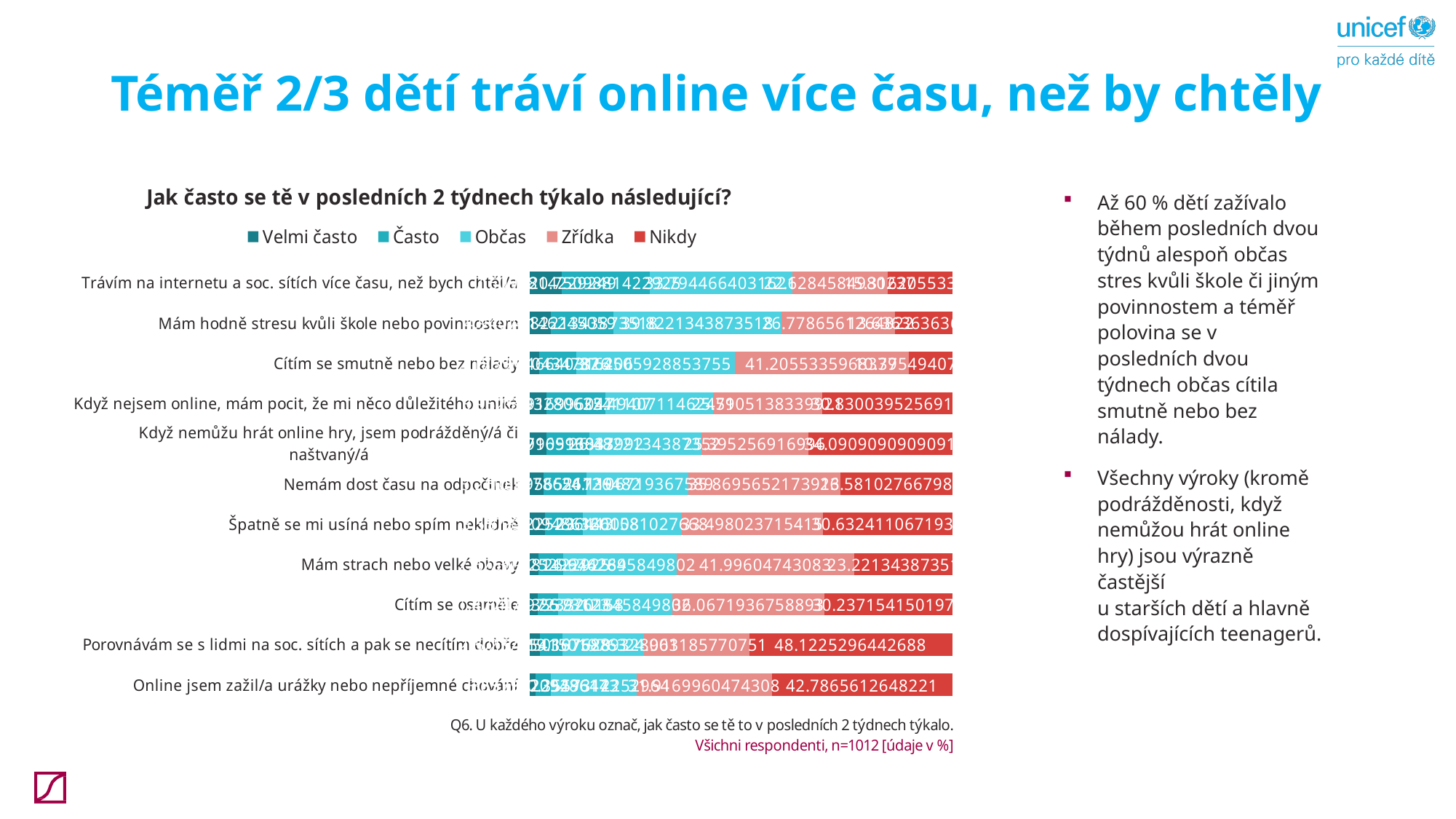
How many series does the chart legend list? 5 What is the 'Nikdy' value for 'Online jsem zažil/a urážky nebo nepříjemné chování'? 42.7865612648221 Which statement has the smallest 'Nikdy' segment? Cítím se smutně nebo bez nálady Which legend entry is shown in the darkest red colour? Nikdy What kind of chart is shown on the slide? Stacked bar chart Which statement has the largest 'Velmi často' segment? Trávím na internetu a soc. sítích více času, než bych chtěl/a How many statements (categories) are plotted in the chart? 11 What is the title of the chart? Jak často se tě v posledních 2 týdnech týkalo následující? Which has the larger 'Zřídka' segment: 'Cítím se smutně nebo bez nálady' or 'Trávím na internetu a soc. sítích více času, než bych chtěl/a'? Cítím se smutně nebo bez nálady Which has the larger 'Nikdy' segment: 'Porovnávám se s lidmi na soc. sítích a pak se necítím dobře' or 'Trávím na internetu a soc. sítích více času, než bych chtěl/a'? Porovnávám se s lidmi na soc. sítích a pak se necítím dobře What is the 'Nikdy' value for 'Porovnávám se s lidmi na soc. sítích a pak se necítím dobře'? 48.1225296442688